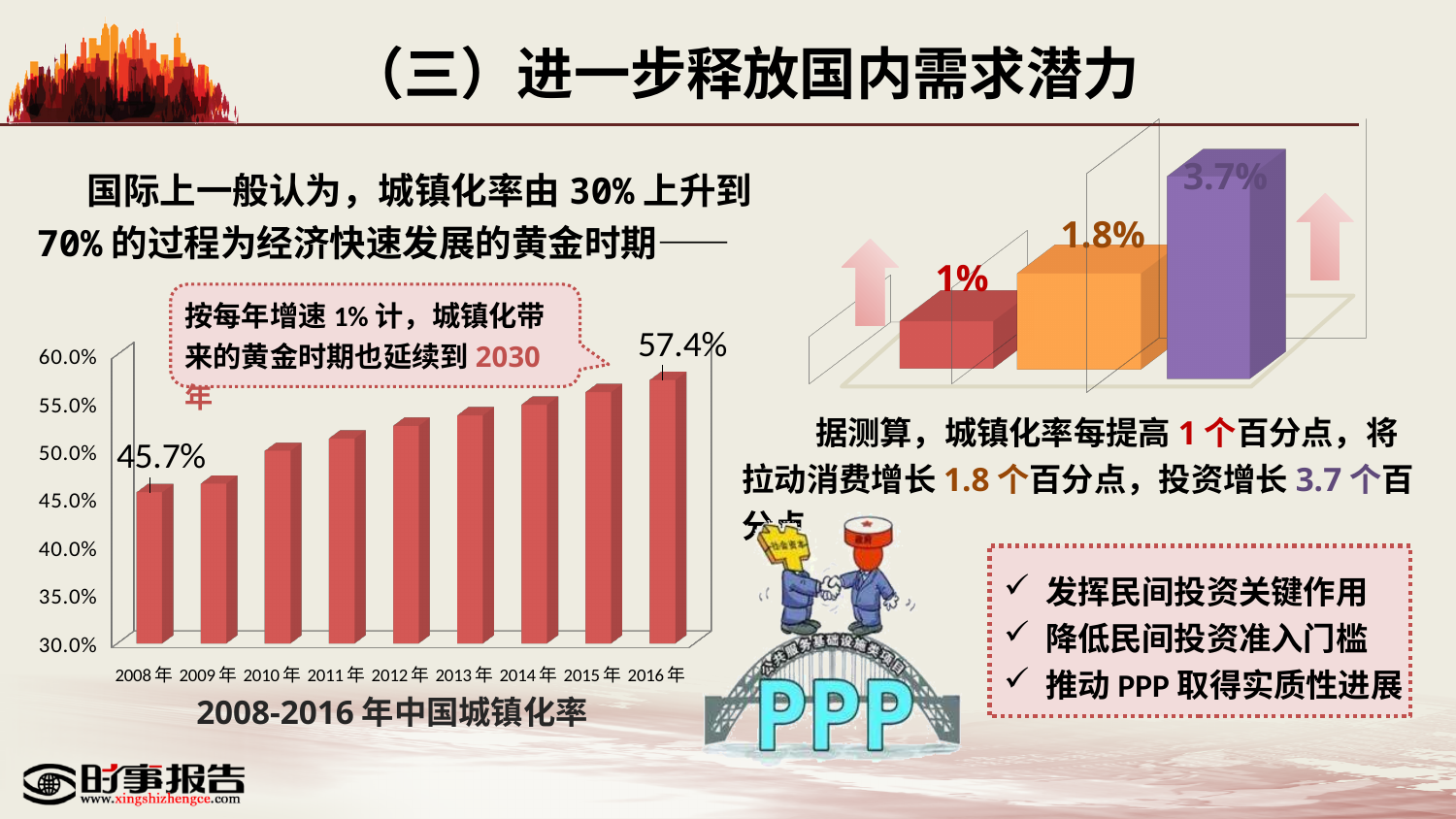
In the 3D bar chart at the top right of the slide, what is the highest value shown? 3.7% In the chart titled 2008-2016年中国城镇化率, do the values rise or fall from 2008年 to 2016年? rise What kind of chart is the chart titled 2008-2016年中国城镇化率? bar chart In the chart titled 2008-2016年中国城镇化率, what is the value for 2016年? 57.4% In the chart titled 2008-2016年中国城镇化率, which year has the highest value? 2016年 In the chart titled 2008-2016年中国城镇化率, how many years are shown on the x axis? 9 In the chart titled 2008-2016年中国城镇化率, is the value for 2012年 greater or less than 50.0%? greater In the chart titled 2008-2016年中国城镇化率, which year has the lowest value? 2008年 In the chart titled 2008-2016年中国城镇化率, is the value for 2009年 greater or less than 50.0%? less In the chart titled 2008-2016年中国城镇化率, what is the value for 2008年? 45.7% In the chart titled 2008-2016年中国城镇化率, what is the difference between the 2016年 value and the 2008年 value? 11.7% In the 3D bar chart at the top right of the slide, how many bars are there? 3